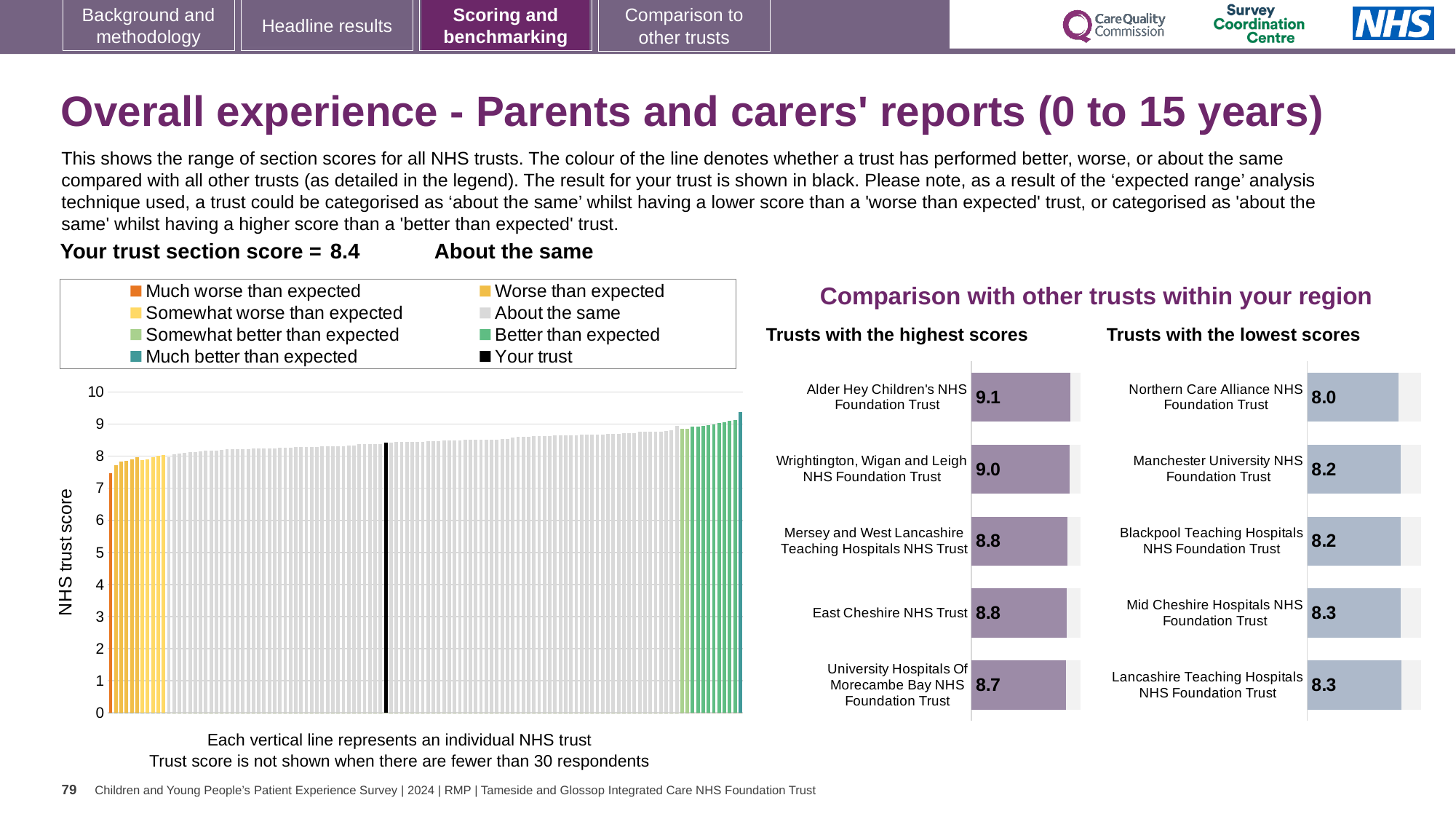
In the 'Trusts with the lowest scores' chart, what is the score for Northern Care Alliance NHS Foundation Trust? 8.0 In the 'Trusts with the highest scores' chart, which trust has the highest score? Alder Hey Children's NHS Foundation Trust In the 'Trusts with the lowest scores' chart, what is the difference between the scores of Lancashire Teaching Hospitals NHS Foundation Trust and Northern Care Alliance NHS Foundation Trust? 0.3 What kind of chart is the large 'NHS trust score' chart on the left of the slide? Bar chart In the 'Trusts with the highest scores' chart, which has the larger score: Wrightington, Wigan and Leigh NHS Foundation Trust or Mersey and West Lancashire Teaching Hospitals NHS Trust? Wrightington, Wigan and Leigh NHS Foundation Trust How many entries does the legend above the 'NHS trust score' chart list? 8 In the 'Trusts with the lowest scores' chart, which trust has the lowest score? Northern Care Alliance NHS Foundation Trust In the 'Trusts with the highest scores' chart, what is the difference between the scores of Alder Hey Children's NHS Foundation Trust and University Hospitals Of Morecambe Bay NHS Foundation Trust? 0.4 In the 'NHS trust score' chart on the left, what is the section score for your trust (the black bar)? 8.4 How many trusts are listed in the 'Trusts with the highest scores' chart? 5 In the 'NHS trust score' chart on the left, do the trust scores rise or fall from left to right? Rise In the 'Trusts with the highest scores' chart, what is the score for Alder Hey Children's NHS Foundation Trust? 9.1